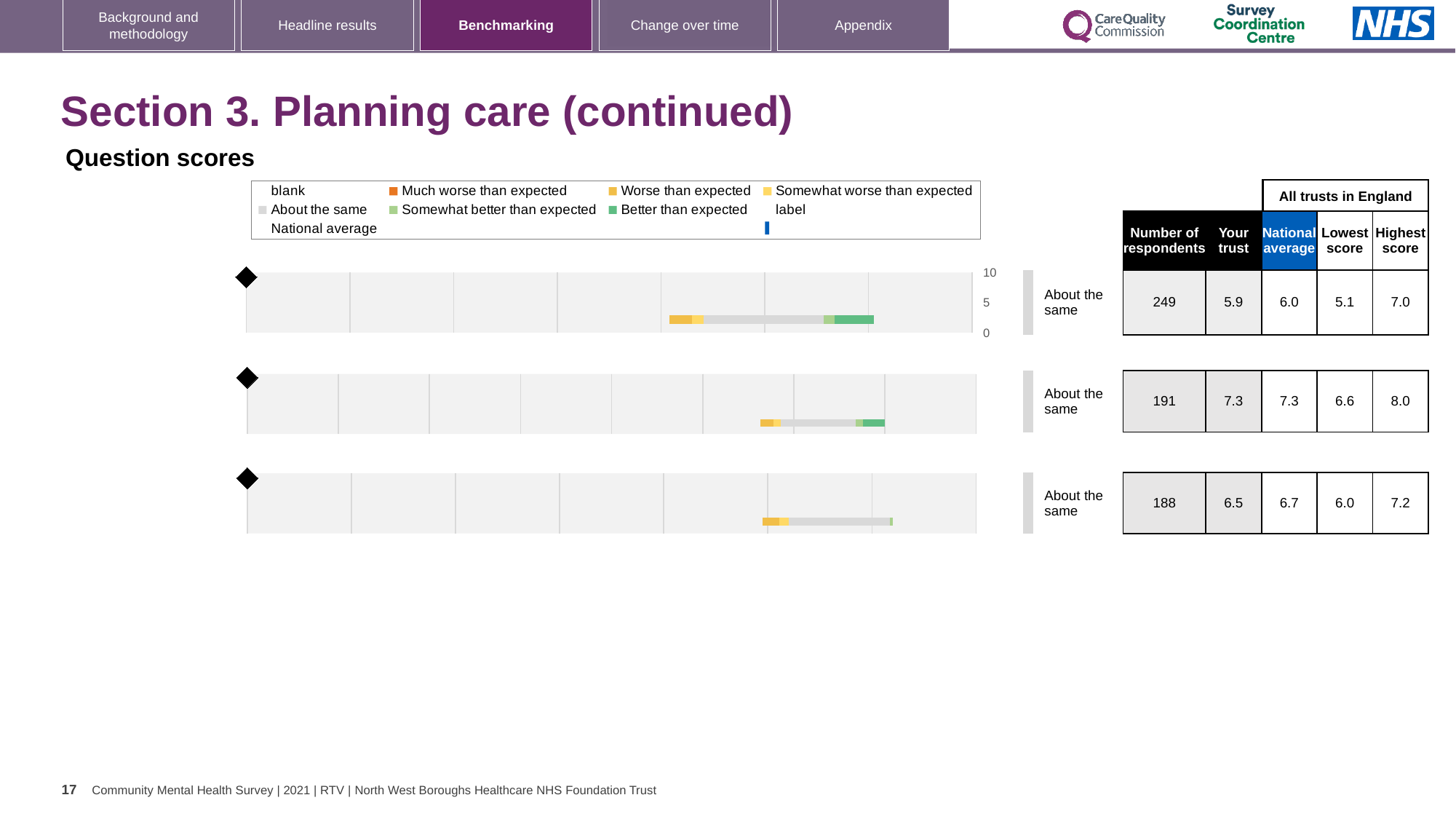
For the middle chart, what is the national average score? 7.3 What is the highest value shown on the vertical axis of the top chart? 10 What benchmark category is shown next to the middle chart? About the same For the top chart, what is the difference between the highest score and the lowest score? 1.9 For the bottom chart, what is the lowest score among all trusts in England? 6.0 For the bottom chart, which is larger: the 'Your trust' score or the national average? National average For the bottom chart, what is the highest score among all trusts in England? 7.2 Which of the three charts has the largest number of respondents? The top chart (249) What kind of chart is used for the three question score charts on the slide? bar chart For the top chart, what is the 'Your trust' score? 5.9 How many question score charts are shown on the slide? 3 For the top chart, what is the number of respondents shown in the table? 249